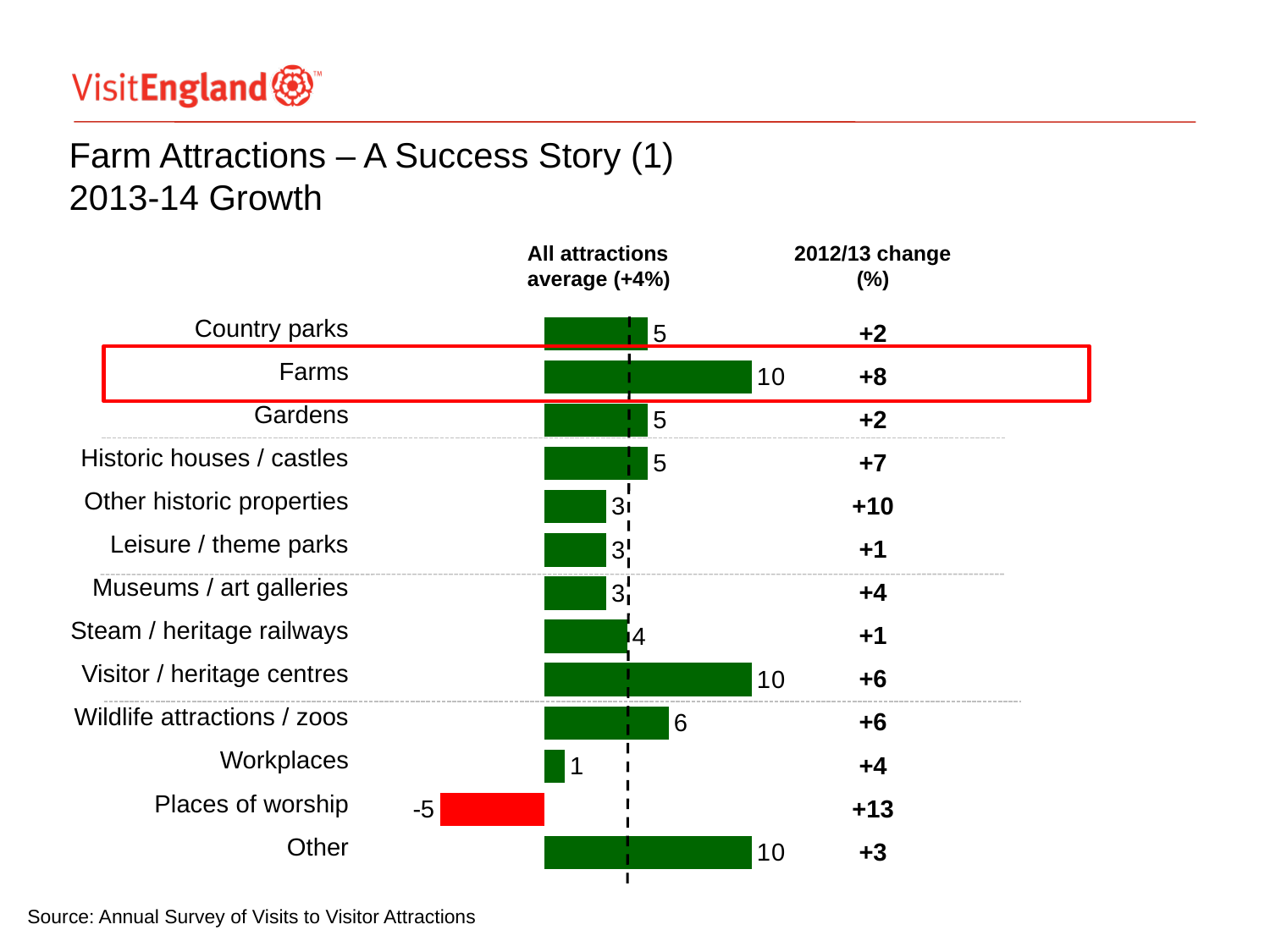
How many categories are shown in the chart? 13 Which category has the lowest value in the chart? Places of worship What is the value shown for Steam / heritage railways? 4 What is the value shown for Places of worship? -5 What is the difference between the values for Farms and Country parks? 5 What is the value shown for Wildlife attractions / zoos? 6 What does the dashed vertical line in the chart represent? All attractions average (+4%) What kind of chart is shown on the slide? Bar chart What is the 2013-14 growth value shown for Farms? 10 Which has a larger value, Farms or Gardens? Farms What is the difference between the values for Wildlife attractions / zoos and Workplaces? 5 What colour is the bar for Places of worship? Red